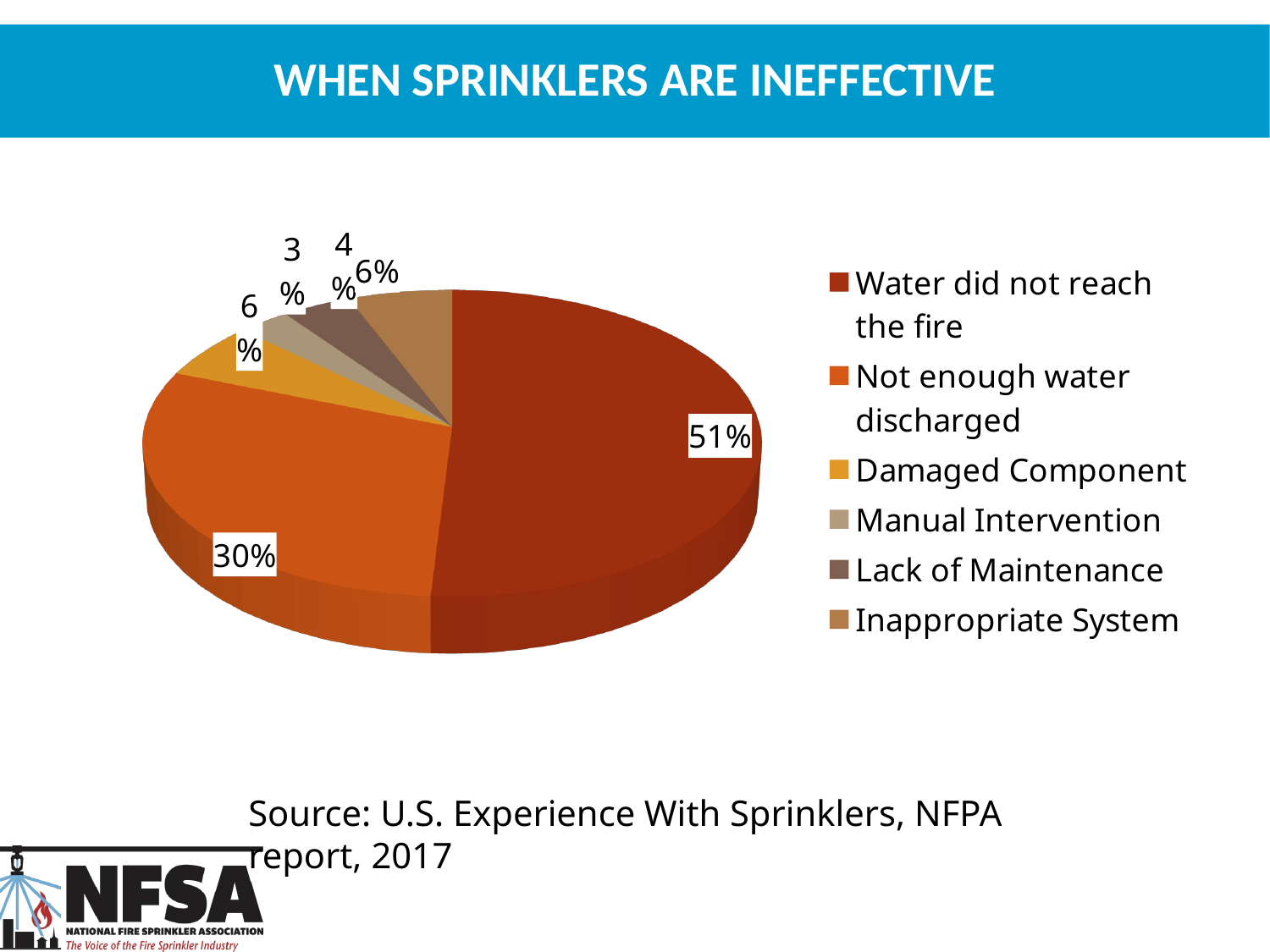
What kind of chart is shown on the slide? pie chart What is the title of the slide containing the chart? WHEN SPRINKLERS ARE INEFFECTIVE Which is larger, the share for 'Lack of Maintenance' or the share for 'Manual Intervention'? Lack of Maintenance Which category has the smallest share of the pie? Manual Intervention Which category has the largest share of the pie? Water did not reach the fire What share of the pie is 'Manual Intervention'? 3% What share of the pie is 'Damaged Component'? 6% What share of the pie is 'Lack of Maintenance'? 4% What share of the pie is 'Not enough water discharged'? 30% What share of the pie is 'Water did not reach the fire'? 51% What is the difference between the shares for 'Water did not reach the fire' and 'Not enough water discharged'? 21% How many categories does the legend list? 6